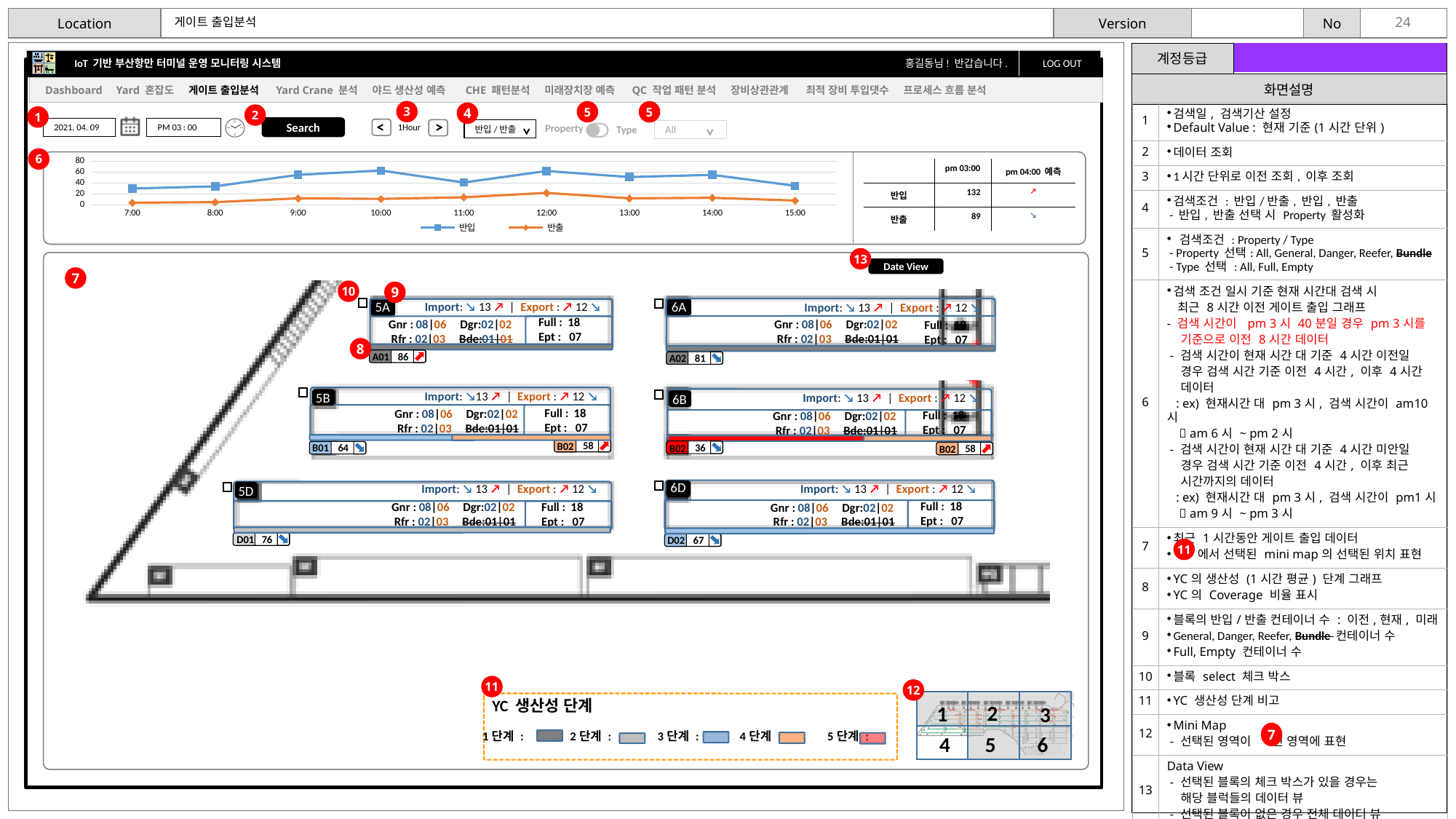
At 12:00, which series has the larger value, 반입 or 반출? 반입 What are the two legend entries of the line chart? 반입 and 반출 Is the value for 반입 at 7:00 greater or less than 40? less How many series does the legend of the line chart list? 2 How many time points are plotted along the x axis of the line chart? 9 What kind of chart is shown in the top panel of the slide? line chart What is the first time label on the x axis of the line chart? 7:00 For the 반입 series, which is larger, the value at 9:00 or the value at 11:00? 9:00 Does the 반입 series rise or fall from 8:00 to 10:00? rise Is the value for 반입 at 10:00 greater or less than 40? greater Is the value for 반출 at 12:00 greater or less than 40? less At which time does the 반출 series reach its highest value? 12:00